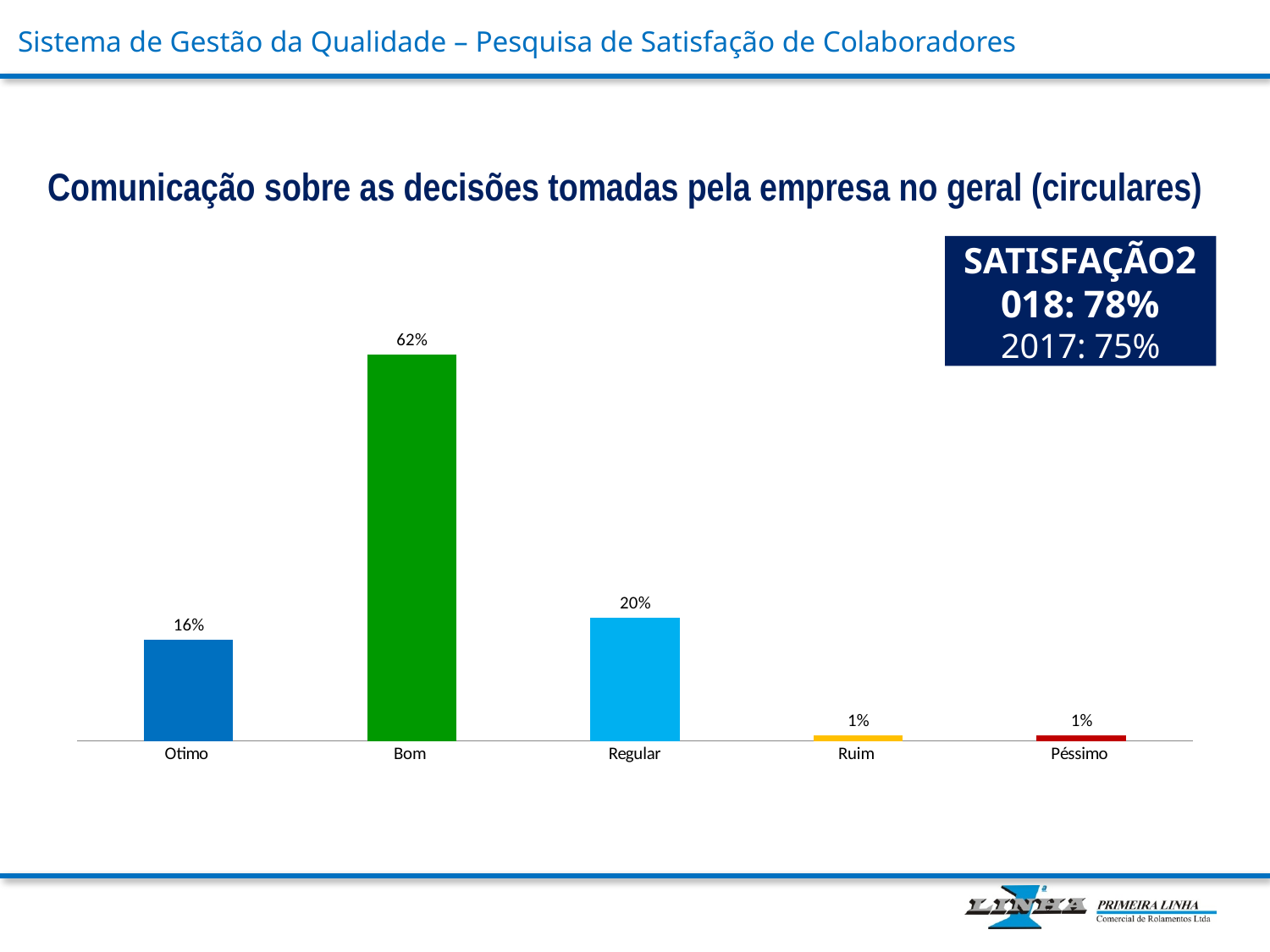
What is the combined value of Ruim and Péssimo? 2% What is the difference between the values for Bom and Regular? 42% What colour is the bar for Bom? Green Which is larger, the value for Otimo or the value for Regular? Regular What is the value for Ruim? 1% Which category has the highest value? Bom What is the value for Otimo? 16% How many categories are shown on the x axis? 5 What is the value for Bom? 62% What is the difference between the values for Regular and Otimo? 4% What is the value for Regular? 20% What kind of chart is shown on the slide? Bar chart